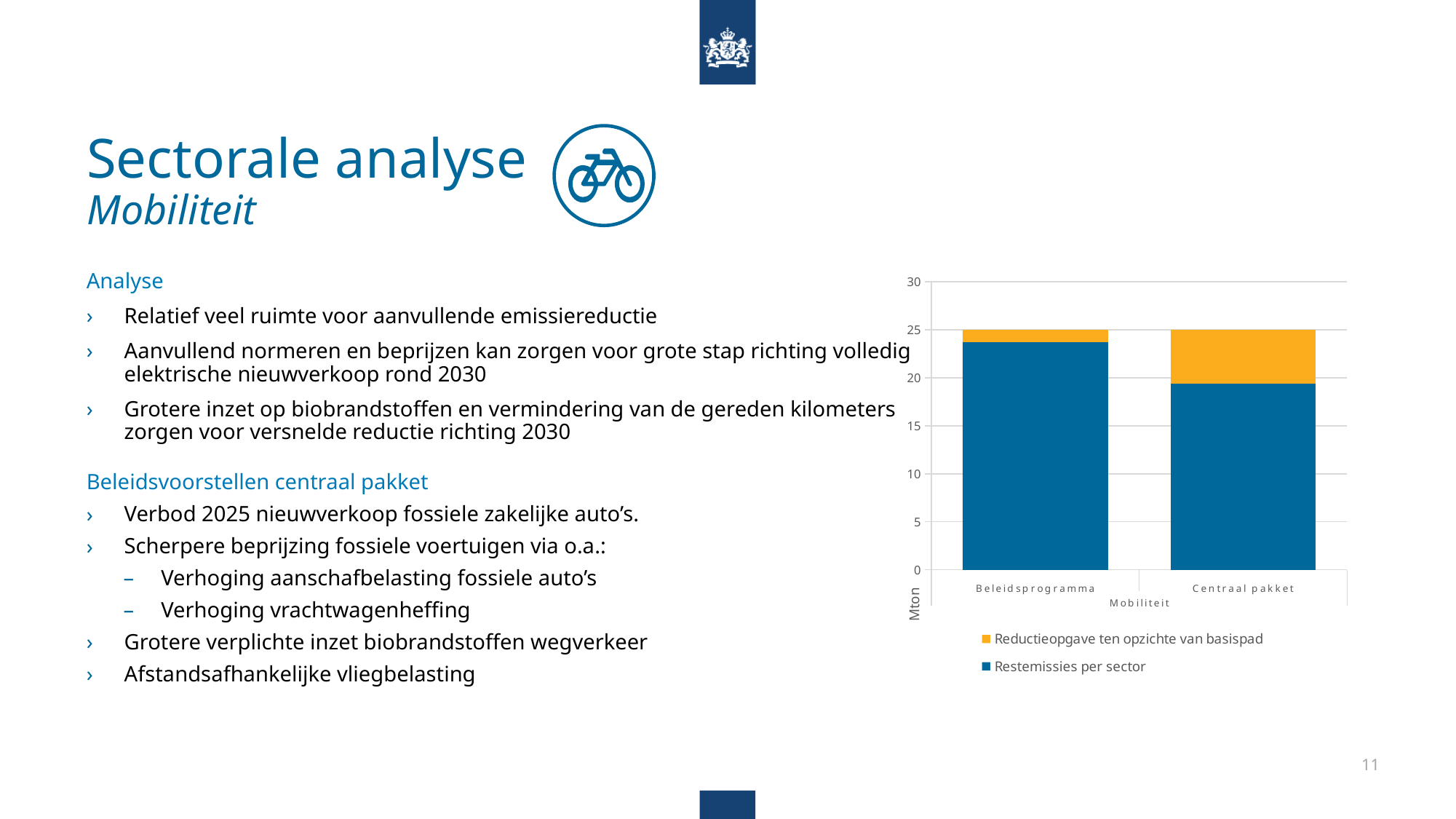
How many categories are shown on the x axis of the chart? 2 Is the value of Restemissies per sector for Centraal pakket greater or less than 20? less Which colour represents Restemissies per sector in the chart? Blue What is the total height of the stacked bar for Centraal pakket? 25 Which category has the larger value for Restemissies per sector, Beleidsprogramma or Centraal pakket? Beleidsprogramma What is the total height of the stacked bar for Beleidsprogramma? 25 What kind of chart is shown on the slide? Stacked bar chart How many series does the chart legend list? 2 Is the value of Restemissies per sector for Beleidsprogramma greater or less than 20? greater What unit is shown on the y axis of the chart? Mton Which category has the larger value for Reductieopgave ten opzichte van basispad, Beleidsprogramma or Centraal pakket? Centraal pakket Is the value of Reductieopgave ten opzichte van basispad for Centraal pakket greater or less than 10? less